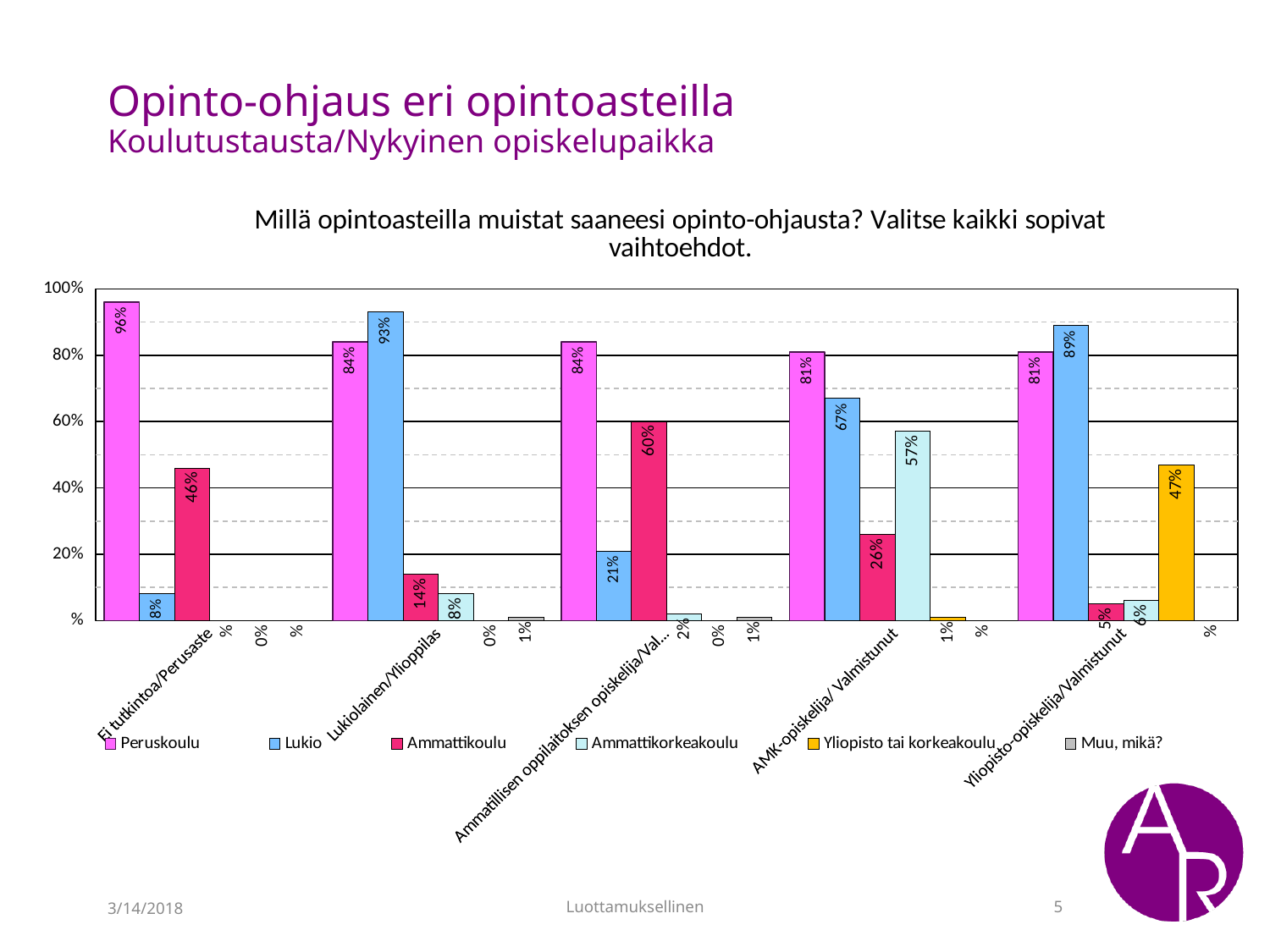
What is the value for Peruskoulu in the Ei tutkintoa/Perusaste category? 96% What is the value for Yliopisto tai korkeakoulu in the Yliopisto-opiskelija/Valmistunut category? 47% How many categories are shown on the x axis? 5 In the Lukiolainen/Ylioppilas category, how much higher is the Lukio value than the Peruskoulu value? 9 percentage points Which category has the lowest value for the Lukio series? Ei tutkintoa/Perusaste What is the value for Ammattikoulu in the AMK-opiskelija/ Valmistunut category? 26% What is the value for Ammattikorkeakoulu in the AMK-opiskelija/ Valmistunut category? 57% Which category has the larger Ammattikoulu value: Ei tutkintoa/Perusaste or Ammatillisen oppilaitoksen opiskelija? Ammatillisen oppilaitoksen opiskelija What is the value for Lukio in the Lukiolainen/Ylioppilas category? 93% Which category has the highest value for the Peruskoulu series? Ei tutkintoa/Perusaste What kind of chart is shown on the slide? Bar chart How many series does the legend list? 6